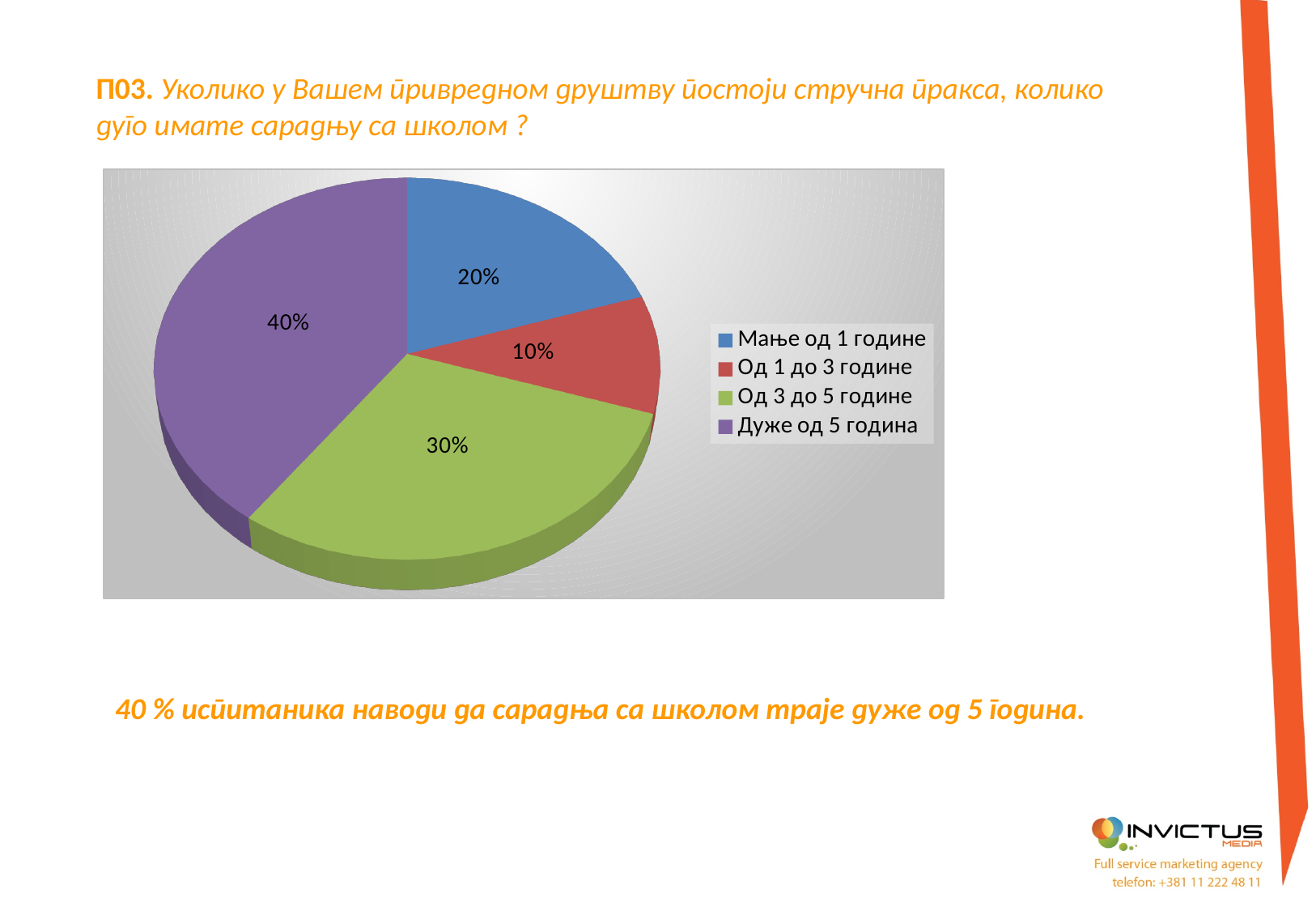
What colour is the slice for "Од 3 до 5 године"? Green How many categories are shown in the pie chart? 4 What is the difference in percentage points between the "Дуже од 5 година" slice and the "Мање од 1 године" slice? 20% Which slice is larger: "Од 3 до 5 године" or "Мање од 1 године"? Од 3 до 5 године What share of the pie does the slice for "Од 3 до 5 године" represent? 30% How many entries does the chart legend list? 4 What share of the pie does the slice for "Дуже од 5 година" represent? 40% What type of chart is shown on the slide? Pie chart Which category has the smallest slice of the pie? Од 1 до 3 године What share of the pie does the slice for "Од 1 до 3 године" represent? 10% Which category has the largest slice of the pie? Дуже од 5 година What share of the pie does the slice for "Мање од 1 године" represent? 20%